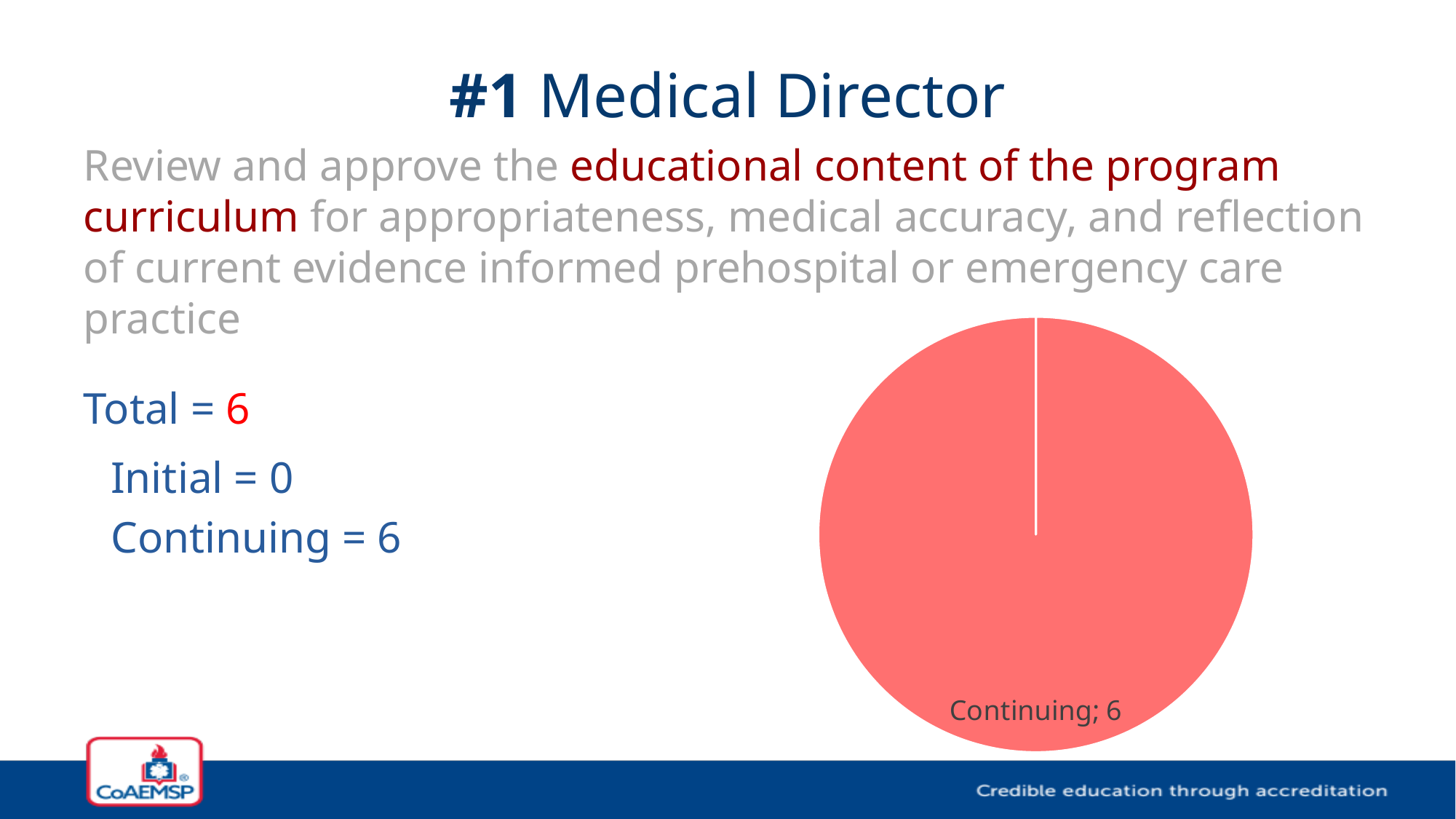
What colour is the Continuing slice in the pie chart? red Is the value for Continuing in the pie chart greater or less than 5? greater What share of the pie does the Continuing slice take up? 100% How many labelled slices does the pie chart show? 1 What kind of chart is shown on the slide? pie chart Which category is labelled on the pie chart? Continuing What value is shown for the Continuing slice in the pie chart? 6